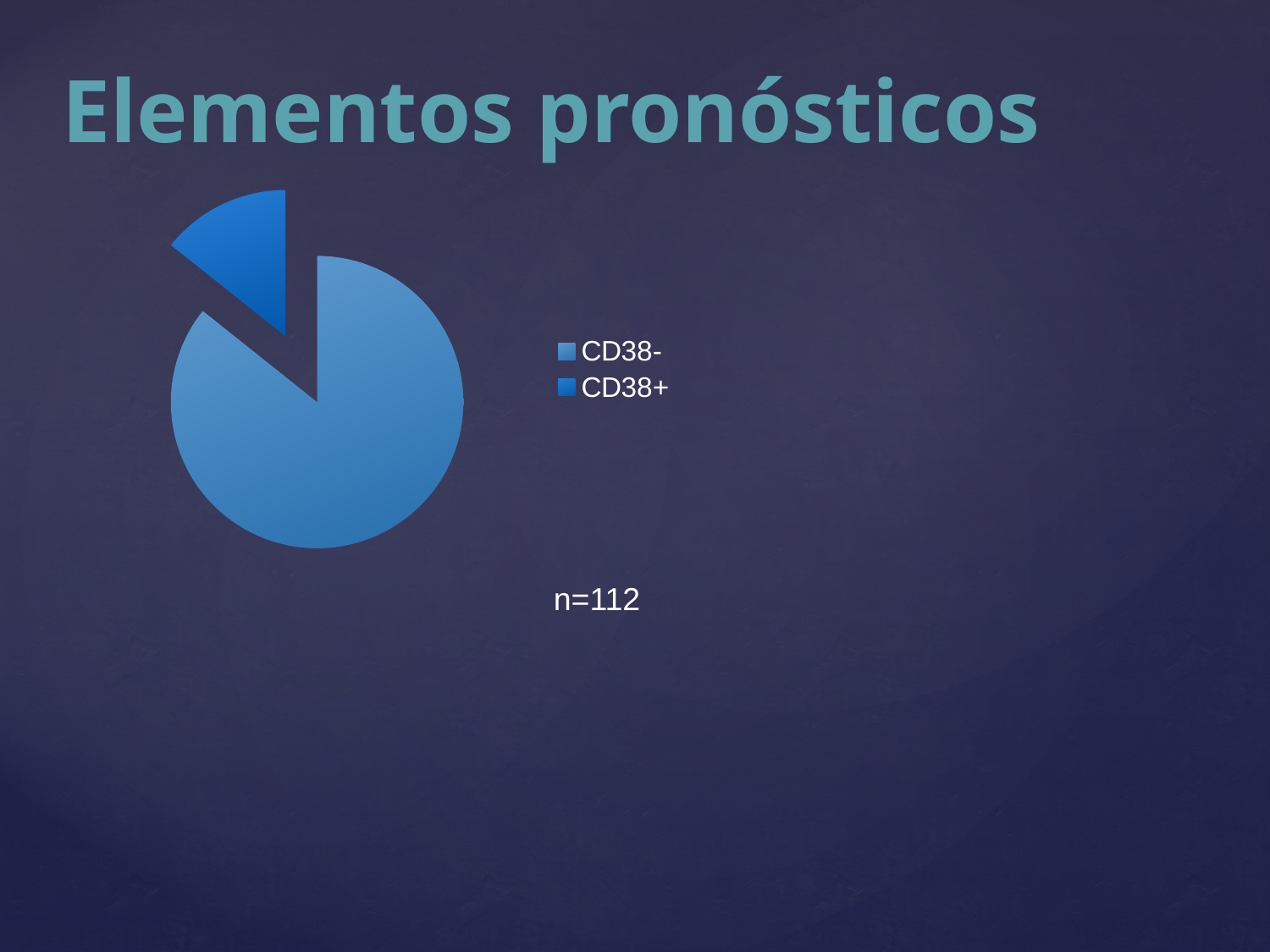
What is the title of the slide containing the pie chart? Elementos pronósticos How many slices does the pie chart have? 2 Which slice is larger in the pie chart, CD38- or CD38+? CD38- Which category has the smallest slice in the pie chart? CD38+ Which category has the largest slice in the pie chart? CD38- What sample size is stated below the pie chart? n=112 How many entries does the legend of the pie chart list? 2 Is the CD38- slice more or less than half of the pie? more What kind of chart is shown on the slide? pie chart